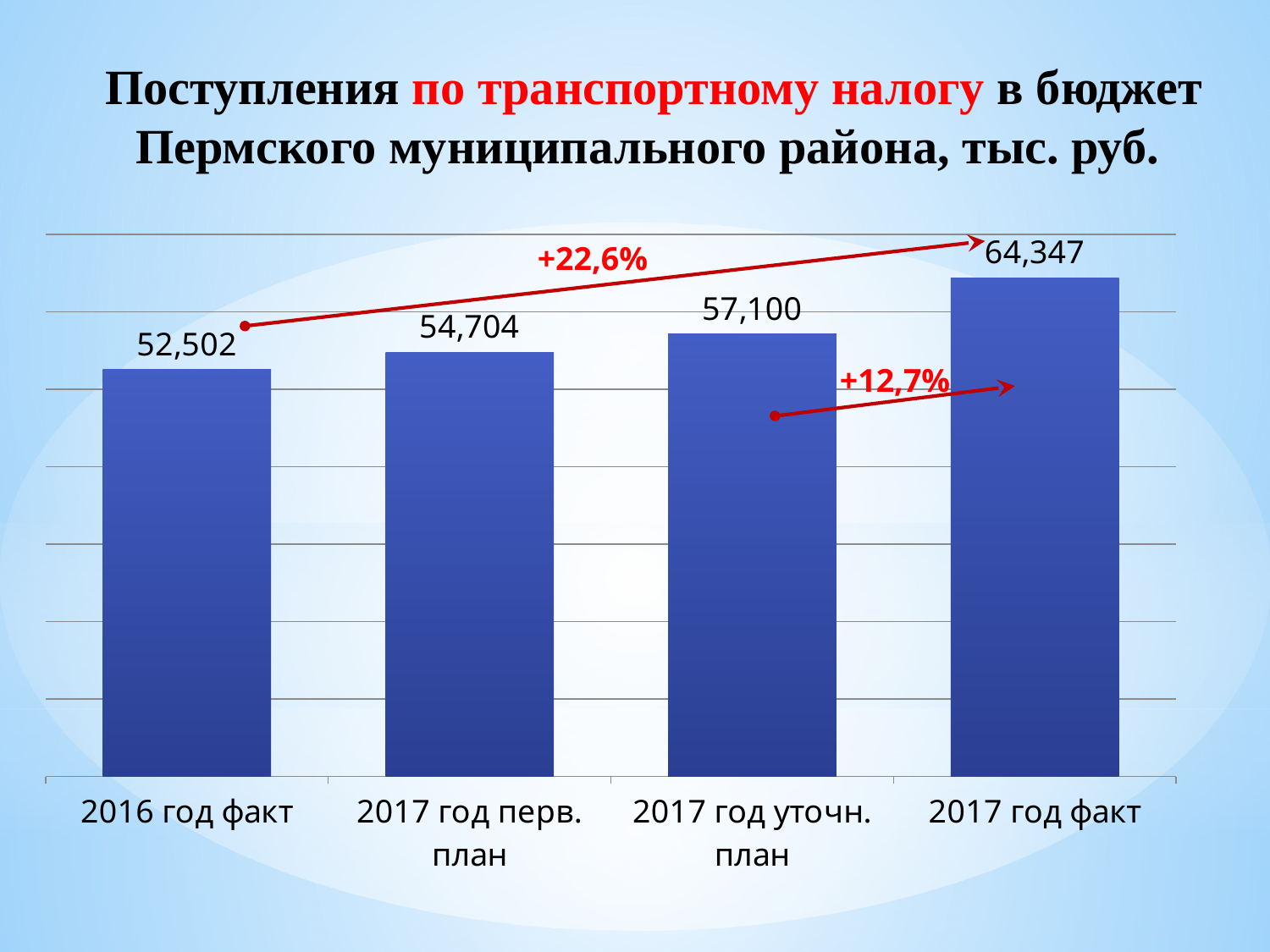
What is the value for 2016 год факт? 52,502 What is the difference between the values for 2017 год факт and 2017 год уточн. план? 7,247 What is the value for 2017 год перв. план? 54,704 Which category has the highest value? 2017 год факт How many categories are shown on the chart? 4 What kind of chart is shown on the slide? Bar chart Which category has the lowest value? 2016 год факт What is the difference between the values for 2017 год факт and 2016 год факт? 11,845 What is the value for 2017 год факт? 64,347 Which is larger, the value for 2017 год перв. план or 2017 год уточн. план? 2017 год уточн. план What percentage change is annotated between 2016 год факт and 2017 год факт? +22,6% What is the value for 2017 год уточн. план? 57,100